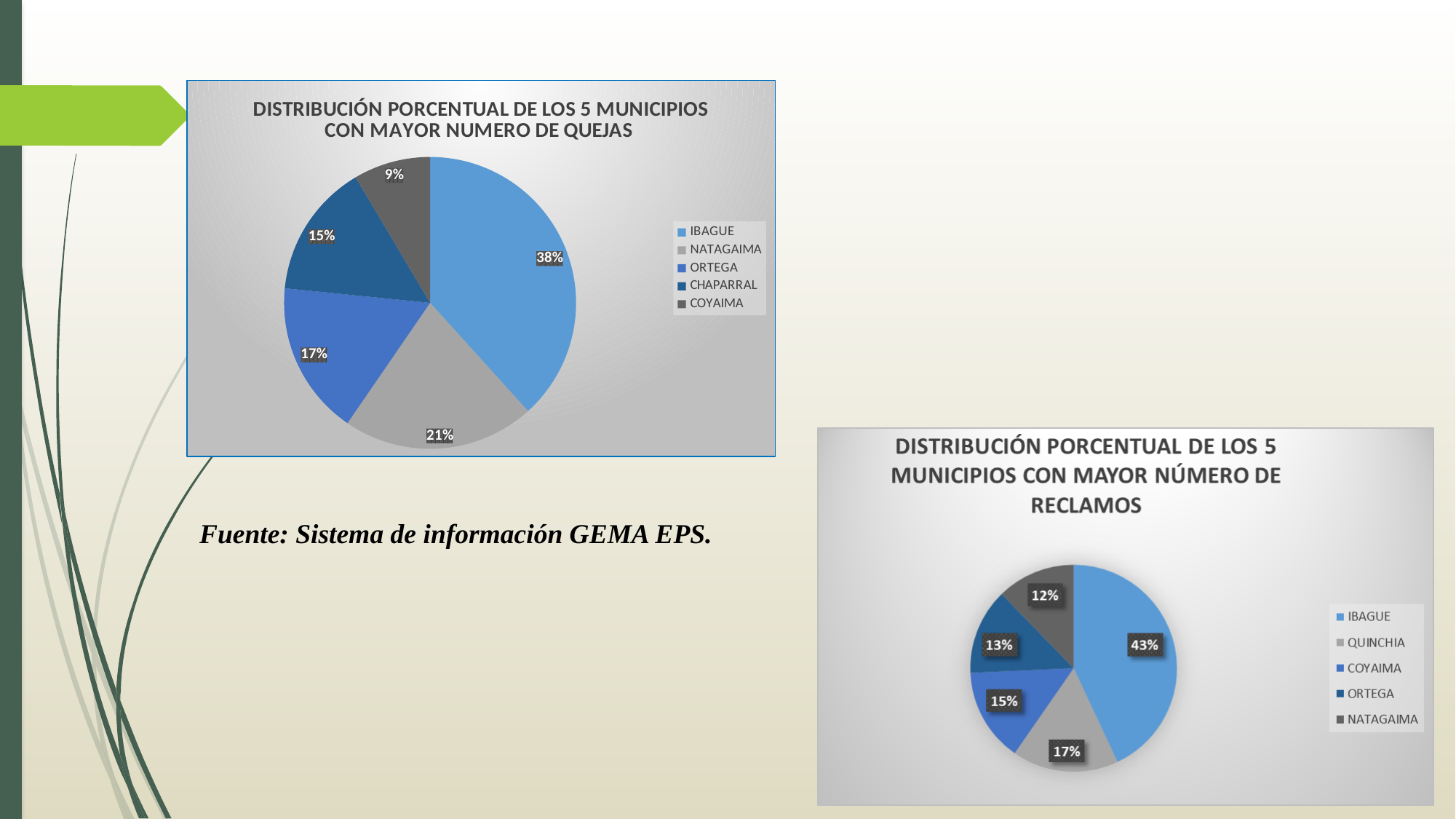
In the chart titled 'DISTRIBUCIÓN PORCENTUAL DE LOS 5 MUNICIPIOS CON MAYOR NÚMERO DE RECLAMOS', what is the difference between the shares of IBAGUE and ORTEGA? 30% In the chart titled 'DISTRIBUCIÓN PORCENTUAL DE LOS 5 MUNICIPIOS CON MAYOR NÚMERO DE RECLAMOS', which is larger, the share of COYAIMA or the share of NATAGAIMA? COYAIMA In the chart titled 'DISTRIBUCIÓN PORCENTUAL DE LOS 5 MUNICIPIOS CON MAYOR NÚMERO DE RECLAMOS', what share does IBAGUE have? 43% In the chart titled 'DISTRIBUCIÓN PORCENTUAL DE LOS 5 MUNICIPIOS CON MAYOR NÚMERO DE RECLAMOS', which municipality has the largest slice? IBAGUE In the chart titled 'DISTRIBUCIÓN PORCENTUAL DE LOS 5 MUNICIPIOS CON MAYOR NUMERO DE QUEJAS', what share does NATAGAIMA have? 21% In the chart titled 'DISTRIBUCIÓN PORCENTUAL DE LOS 5 MUNICIPIOS CON MAYOR NÚMERO DE RECLAMOS', what share does QUINCHIA have? 17% What kind of chart is the one titled 'DISTRIBUCIÓN PORCENTUAL DE LOS 5 MUNICIPIOS CON MAYOR NÚMERO DE RECLAMOS'? Pie chart In the chart titled 'DISTRIBUCIÓN PORCENTUAL DE LOS 5 MUNICIPIOS CON MAYOR NUMERO DE QUEJAS', how many slices does the pie have? 5 In the chart titled 'DISTRIBUCIÓN PORCENTUAL DE LOS 5 MUNICIPIOS CON MAYOR NUMERO DE QUEJAS', which municipality has the smallest slice? COYAIMA In the chart titled 'DISTRIBUCIÓN PORCENTUAL DE LOS 5 MUNICIPIOS CON MAYOR NUMERO DE QUEJAS', what is the difference between the shares of ORTEGA and CHAPARRAL? 2% In the chart titled 'DISTRIBUCIÓN PORCENTUAL DE LOS 5 MUNICIPIOS CON MAYOR NÚMERO DE RECLAMOS', which municipality is listed second in the legend? QUINCHIA